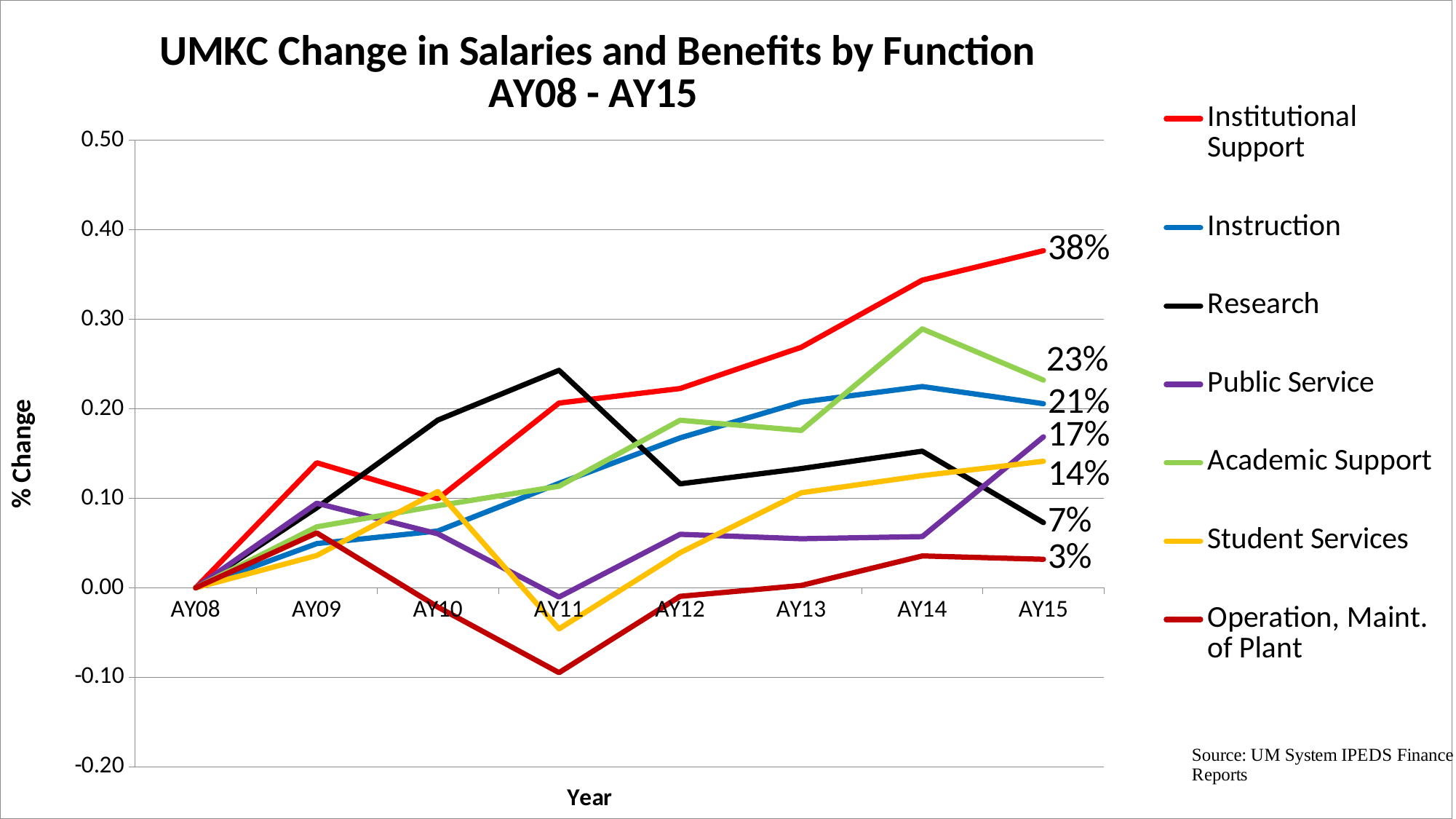
In AY15, which is larger: Public Service or Student Services? Public Service What is the value for Institutional Support in AY15? 38% What is the difference between the AY15 values for Institutional Support and Instruction? 17% Is the value for Research in AY11 greater or less than 0.20? greater Does the Institutional Support line rise or fall from AY11 to AY15? rise Which function has the lowest value in AY15? Operation, Maint. of Plant Which function has the highest value in AY15? Institutional Support How many years are plotted along the x axis? 8 How many series does the legend list? 7 What is the value for Academic Support in AY15? 23% What is the value for Research in AY15? 7% What type of chart is shown on the slide? line chart